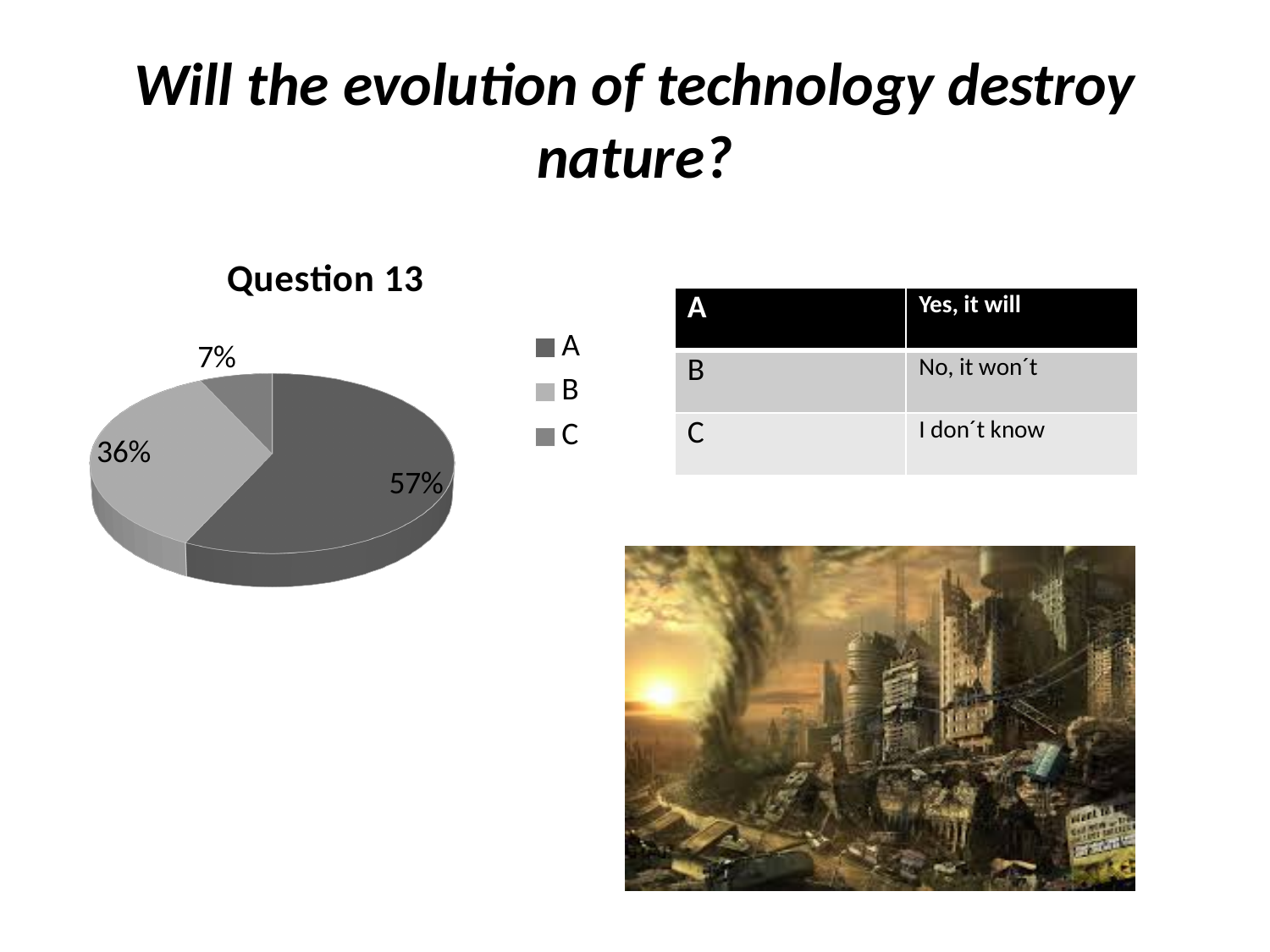
How many slices does the pie chart have? 3 What share of the pie does slice B represent? 36% Which slice of the pie chart is the smallest? C What is the difference in percentage points between slice A and slice B? 21 How many entries does the legend of the pie chart list? 3 What is the title of the pie chart? Question 13 What share of the pie does slice A represent? 57% What type of chart is shown on the slide? pie chart Which is larger, slice B or slice C? B What share of the pie does slice C represent? 7% Which slice of the pie chart is the largest? A What is the difference in percentage points between slice B and slice C? 29